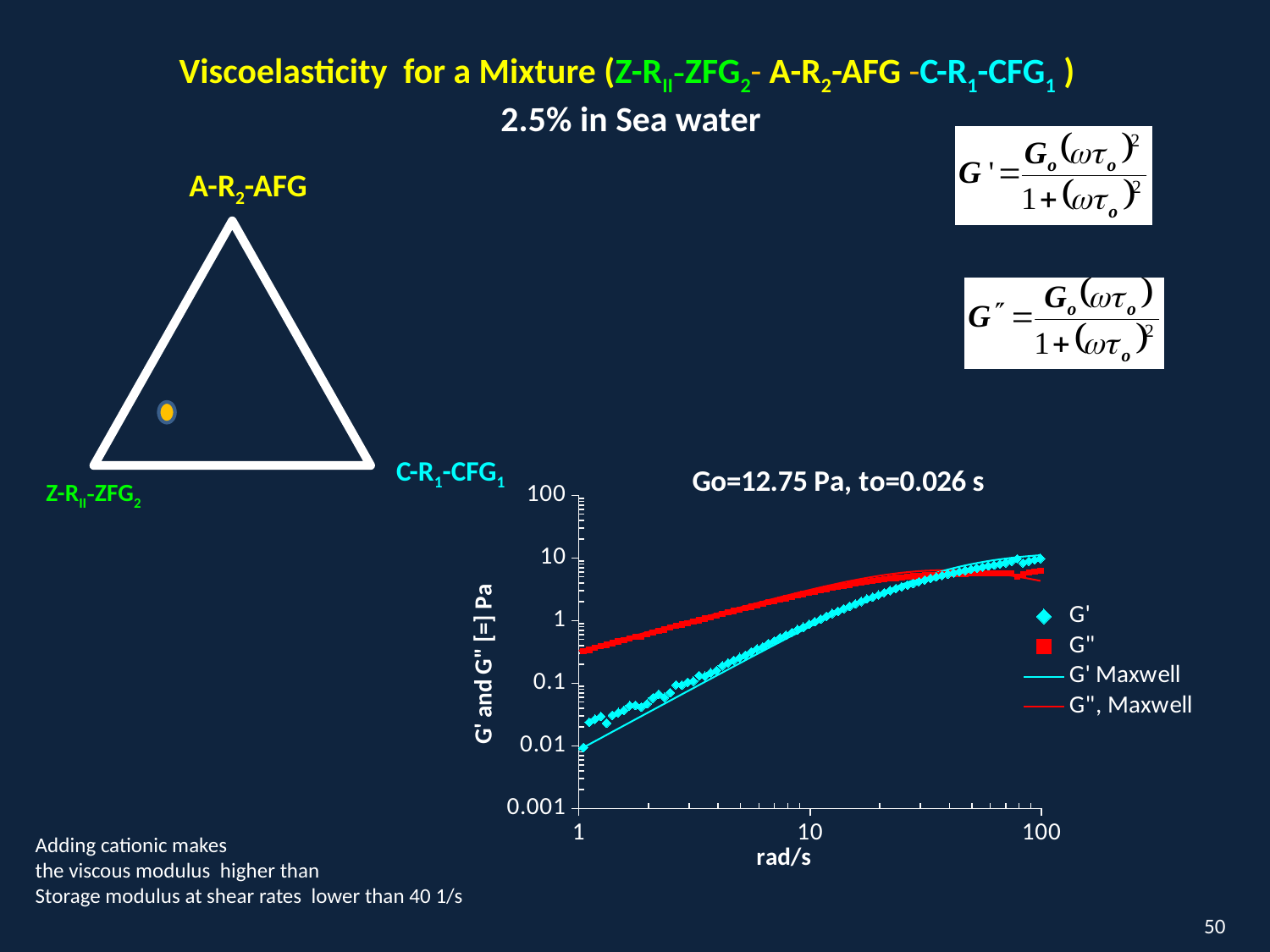
At 10 rad/s, is the value of G'' greater or less than 1 Pa? greater Does the G' series rise or fall as the frequency increases along the x axis? rise At 1 rad/s, which is larger, G' or G''? G'' What is the label of the x axis of the chart? rad/s At 1 rad/s, is the value of G'' greater or less than 0.1 Pa? greater What is the title of the chart? Go=12.75 Pa, to=0.026 s At 1 rad/s, is the value of G' greater or less than 0.1 Pa? less At 100 rad/s, which is larger, G' or G''? G' What kind of chart is shown on the slide? scatter chart with lines (log-log axes) What is the highest value shown on the y axis of the chart? 100 How many series does the chart legend list? 4